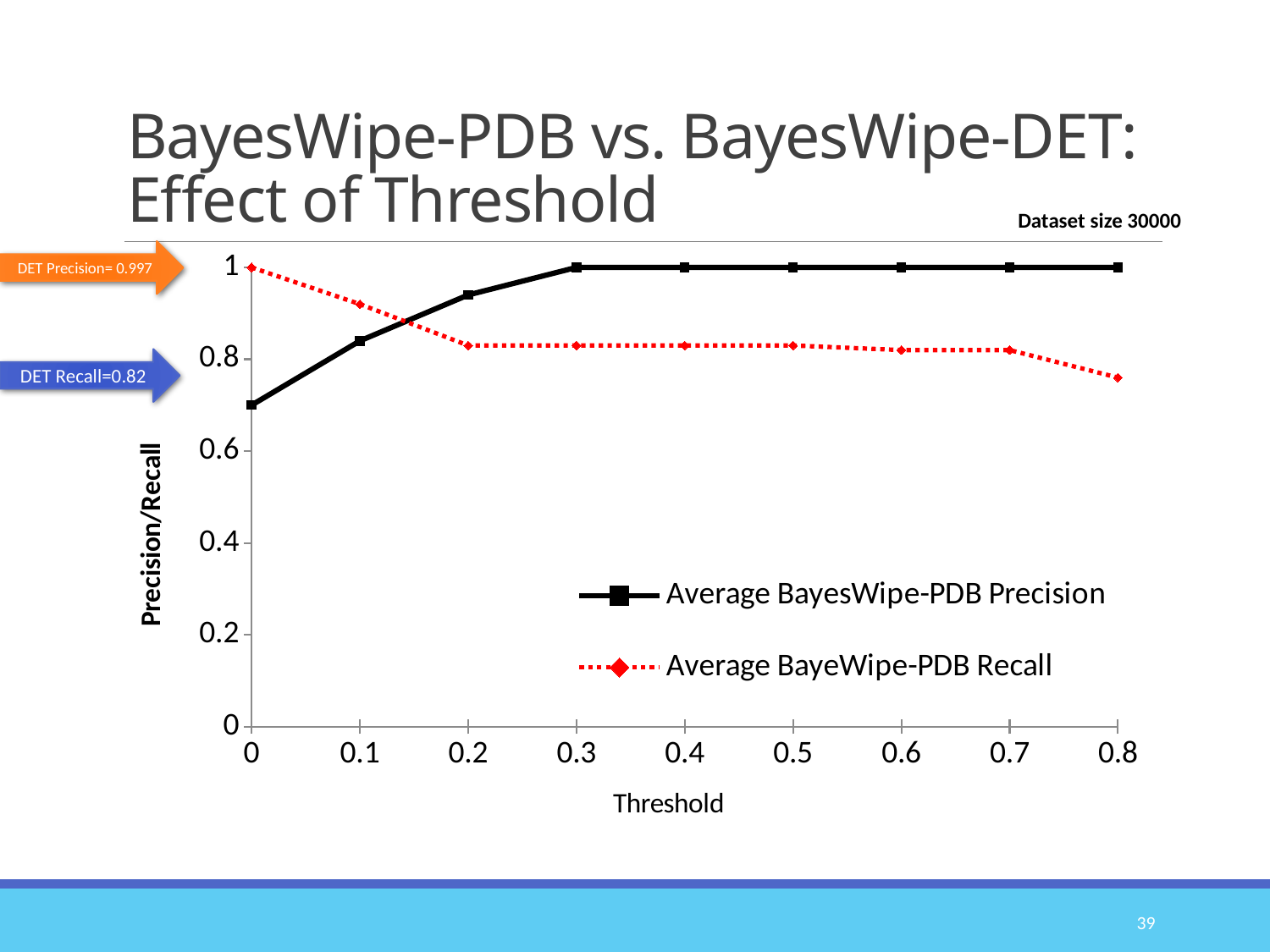
Does the Average BayeWipe-PDB Recall series rise or fall as the threshold increases from 0 to 0.2? fall At threshold 0.8, which series has the larger value, Average BayesWipe-PDB Precision or Average BayeWipe-PDB Recall? Average BayesWipe-PDB Precision What kind of chart is shown on the slide? line chart What is the label of the x axis of the chart? Threshold Is the value of Average BayesWipe-PDB Precision at threshold 0 greater or less than 0.8? less How many series does the legend list? 2 Does the Average BayesWipe-PDB Precision series rise or fall as the threshold increases from 0 to 0.3? rise At threshold 0, which series has the larger value, Average BayesWipe-PDB Precision or Average BayeWipe-PDB Recall? Average BayeWipe-PDB Recall How many threshold values are plotted along the x axis for each series? 9 What is the value of Average BayesWipe-PDB Precision at threshold 0.5? 1 What is the value of Average BayeWipe-PDB Recall at threshold 0? 1 Is the value of Average BayeWipe-PDB Recall at threshold 0.8 greater or less than 0.8? less